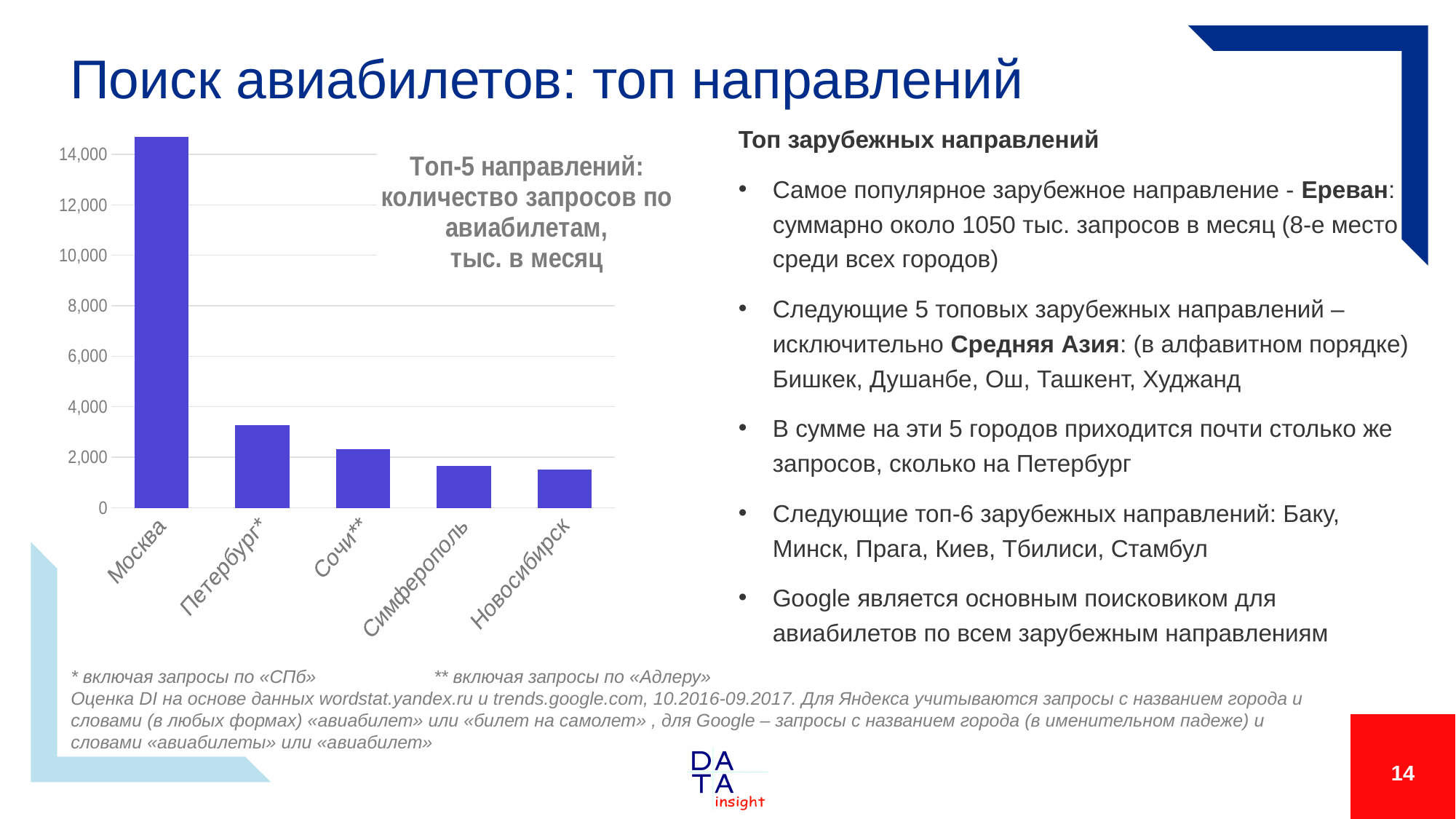
What is the title of the chart? Топ-5 направлений: количество запросов по авиабилетам, тыс. в месяц Is the value for Новосибирск greater or less than 2,000? less Which has a larger value in the chart, Петербург* or Сочи**? Петербург* Is the value for Петербург* greater or less than 2,000? greater Which city has the highest number of requests in the chart? Москва Which has a larger value in the chart, Москва or Петербург*? Москва Which has a larger value in the chart, Сочи** or Новосибирск? Сочи** What kind of chart is shown on the slide? bar chart How many cities are shown on the x axis of the chart? 5 Is the value for Москва greater or less than 12,000? greater Do the values in the chart rise or fall from left to right along the x axis? fall